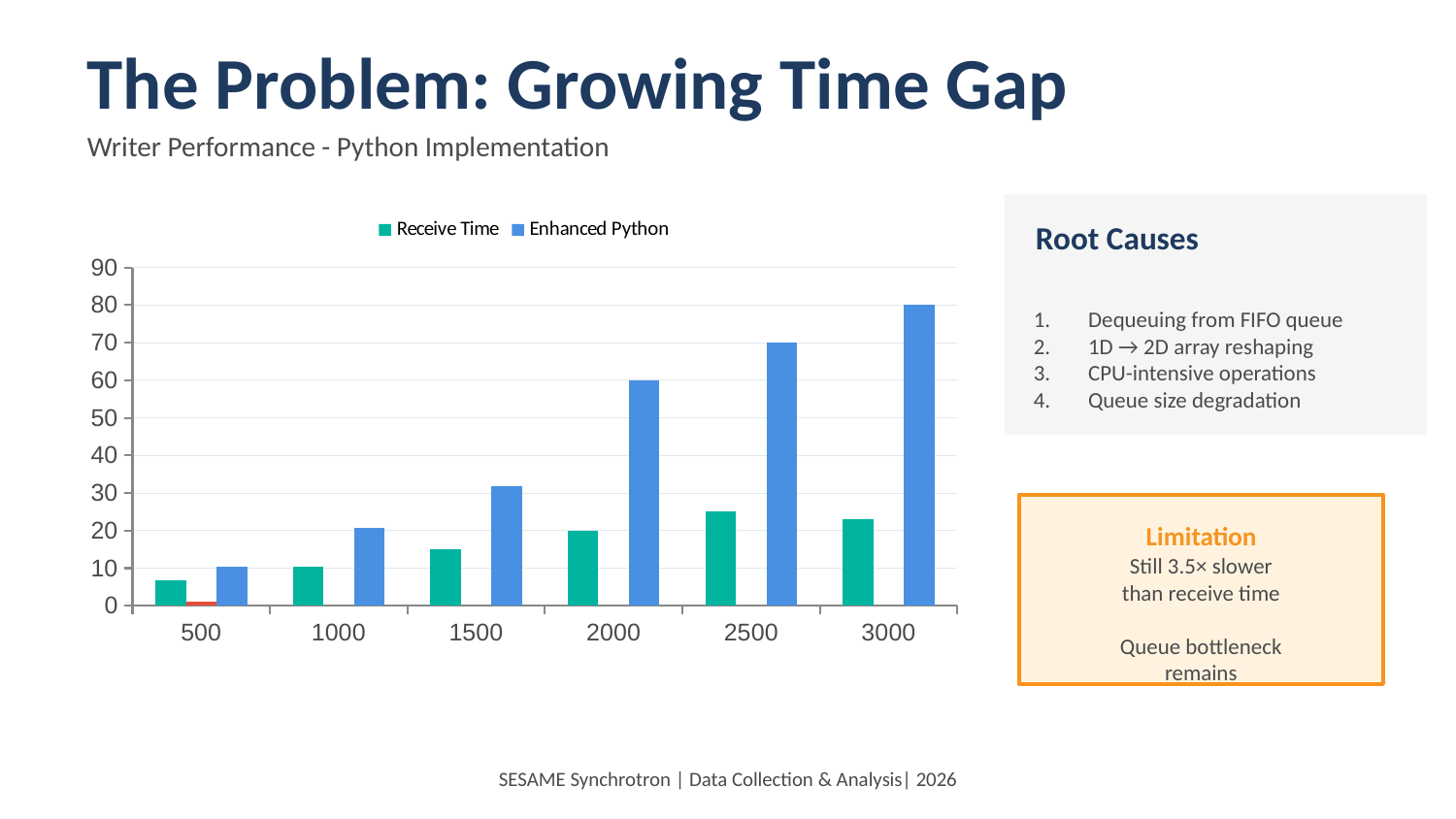
How many categories are shown on the x axis of the chart? 6 At which category is the Receive Time value lowest? 500 How many series does the chart legend list? 2 What kind of chart is shown on the slide? bar chart At which category is the Enhanced Python value highest? 3000 What is the Enhanced Python value at 2500? 70 Is the Enhanced Python value at 2000 greater or less than 50? greater At 3000, which series has the larger value, Receive Time or Enhanced Python? Enhanced Python Which series is shown in blue in the chart legend? Enhanced Python Is the Receive Time value at 2000 greater or less than 30? less What is the Enhanced Python value at 3000? 80 Do the Enhanced Python values rise or fall as the x-axis values increase from 500 to 3000? rise